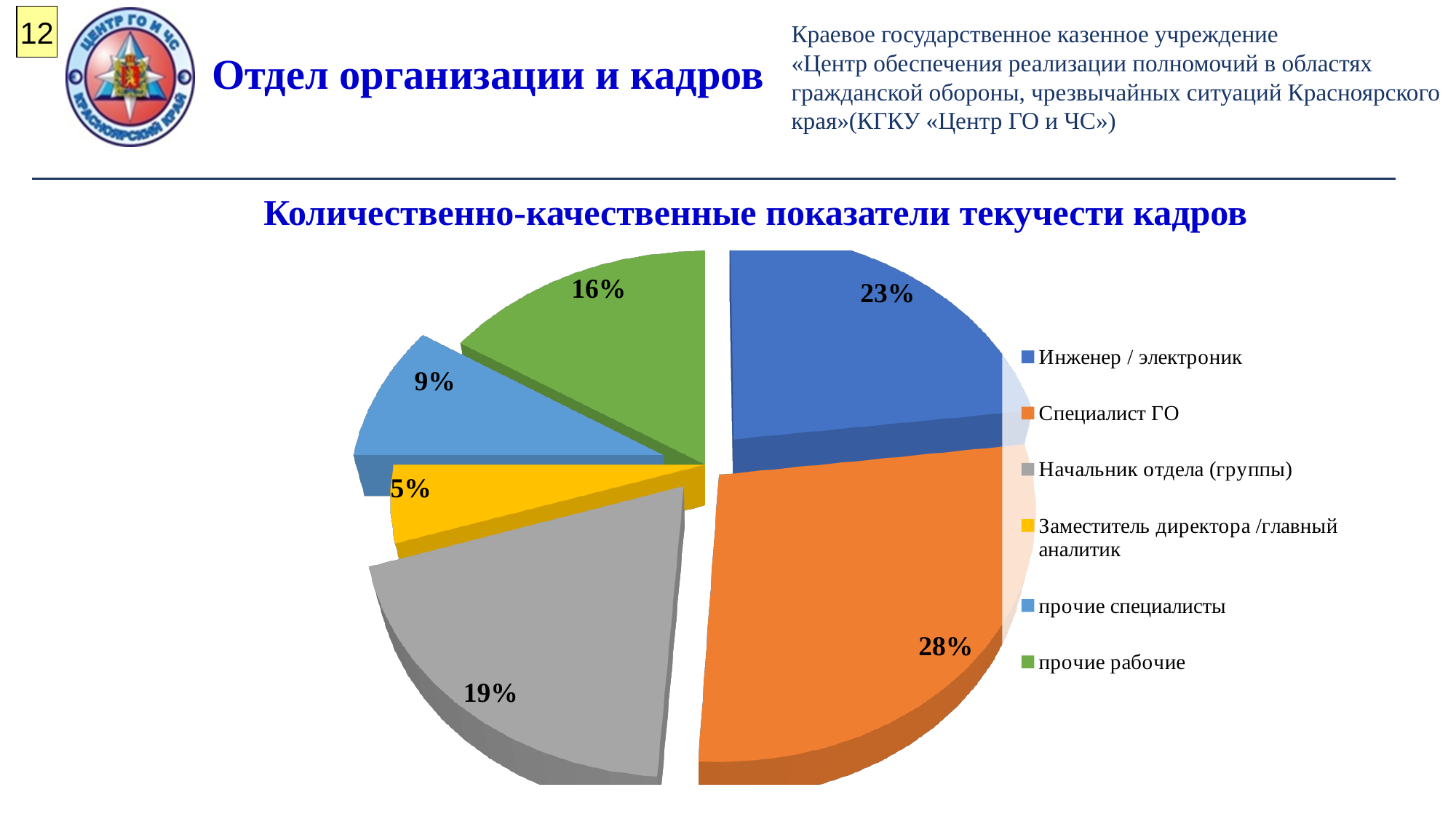
Which category has the largest slice of the pie? Специалист ГО Which category has the smallest slice of the pie? Заместитель директора /главный аналитик What share of the pie does Начальник отдела (группы) have? 19% What share of the pie does Заместитель директора /главный аналитик have? 5% What is the difference in percentage points between Специалист ГО and Инженер / электроник? 5 Which is larger: the share for прочие рабочие or the share for прочие специалисты? прочие рабочие What share of the pie does Специалист ГО have? 28% What kind of chart is shown on the slide? Pie chart What share of the pie does прочие специалисты have? 9% How many categories does the pie chart show? 6 What share of the pie does Инженер / электроник have? 23% What share of the pie does прочие рабочие have? 16%